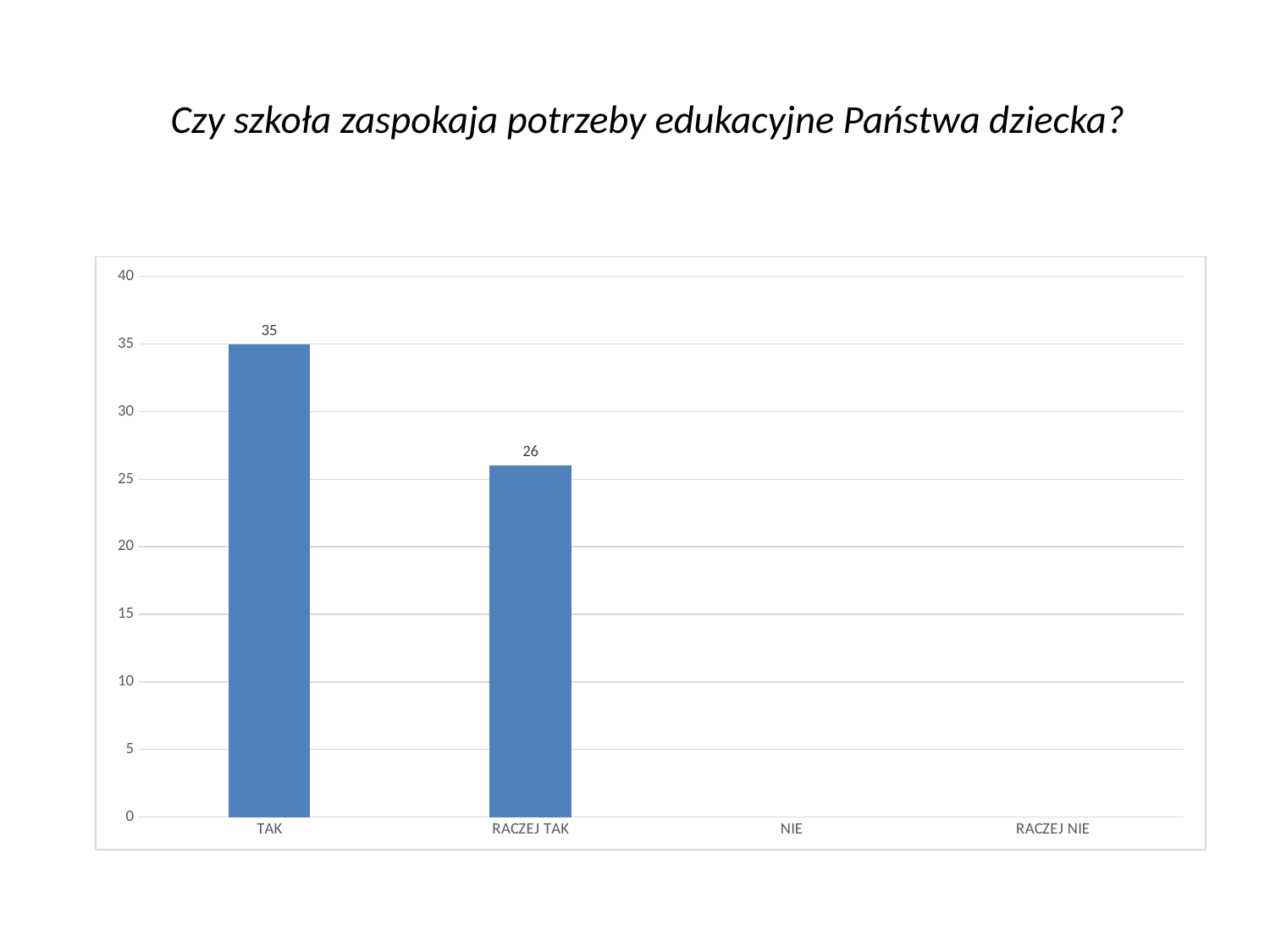
What is the title of the slide? Czy szkoła zaspokaja potrzeby edukacyjne Państwa dziecka? Which category has the highest value? TAK How many categories are shown on the x axis? 4 Is the value for TAK greater or less than 30? greater What is the highest value shown on the y axis? 40 What is the value for TAK? 35 What is the difference between the values for TAK and RACZEJ TAK? 9 What kind of chart is shown on the slide? bar chart What is the value for RACZEJ TAK? 26 Is the value for RACZEJ TAK greater or less than 30? less Which is larger, the value for TAK or the value for RACZEJ TAK? TAK Do the values rise or fall from TAK to RACZEJ TAK? fall